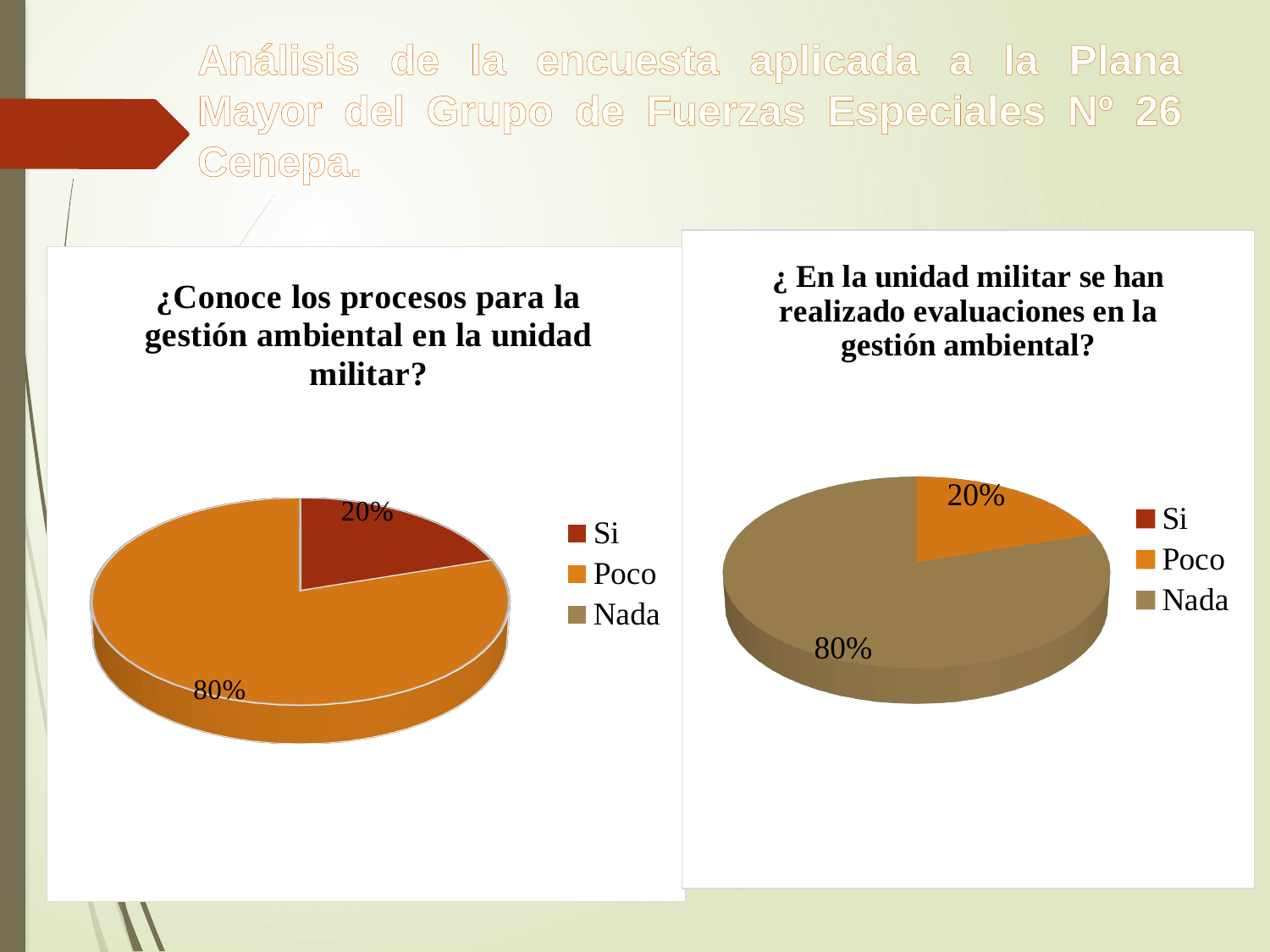
In the right chart (¿En la unidad militar se han realizado evaluaciones en la gestión ambiental?), which category has the largest slice? Nada How many slices are visible in the left chart (¿Conoce los procesos para la gestión ambiental en la unidad militar?)? 2 In the left chart (¿Conoce los procesos para la gestión ambiental en la unidad militar?), which category has the largest slice? Poco How many entries does the legend of the right chart (¿En la unidad militar se han realizado evaluaciones en la gestión ambiental?) list? 3 In the right chart (¿En la unidad militar se han realizado evaluaciones en la gestión ambiental?), what share of the pie is labelled Nada? 80% In the left chart (¿Conoce los procesos para la gestión ambiental en la unidad militar?), what colour is the Si slice? Dark red In the left chart (¿Conoce los procesos para la gestión ambiental en la unidad militar?), what is the difference between the Poco and Si shares? 60% In the right chart (¿En la unidad militar se han realizado evaluaciones en la gestión ambiental?), what share of the pie is labelled Poco? 20% What kind of chart is the left chart (¿Conoce los procesos para la gestión ambiental en la unidad militar?)? Pie chart In the left chart (¿Conoce los procesos para la gestión ambiental en la unidad militar?), what share of the pie is labelled Poco? 80% In the left chart (¿Conoce los procesos para la gestión ambiental en la unidad militar?), what share of the pie is labelled Si? 20% In the right chart (¿En la unidad militar se han realizado evaluaciones en la gestión ambiental?), which is larger, the Nada slice or the Poco slice? Nada